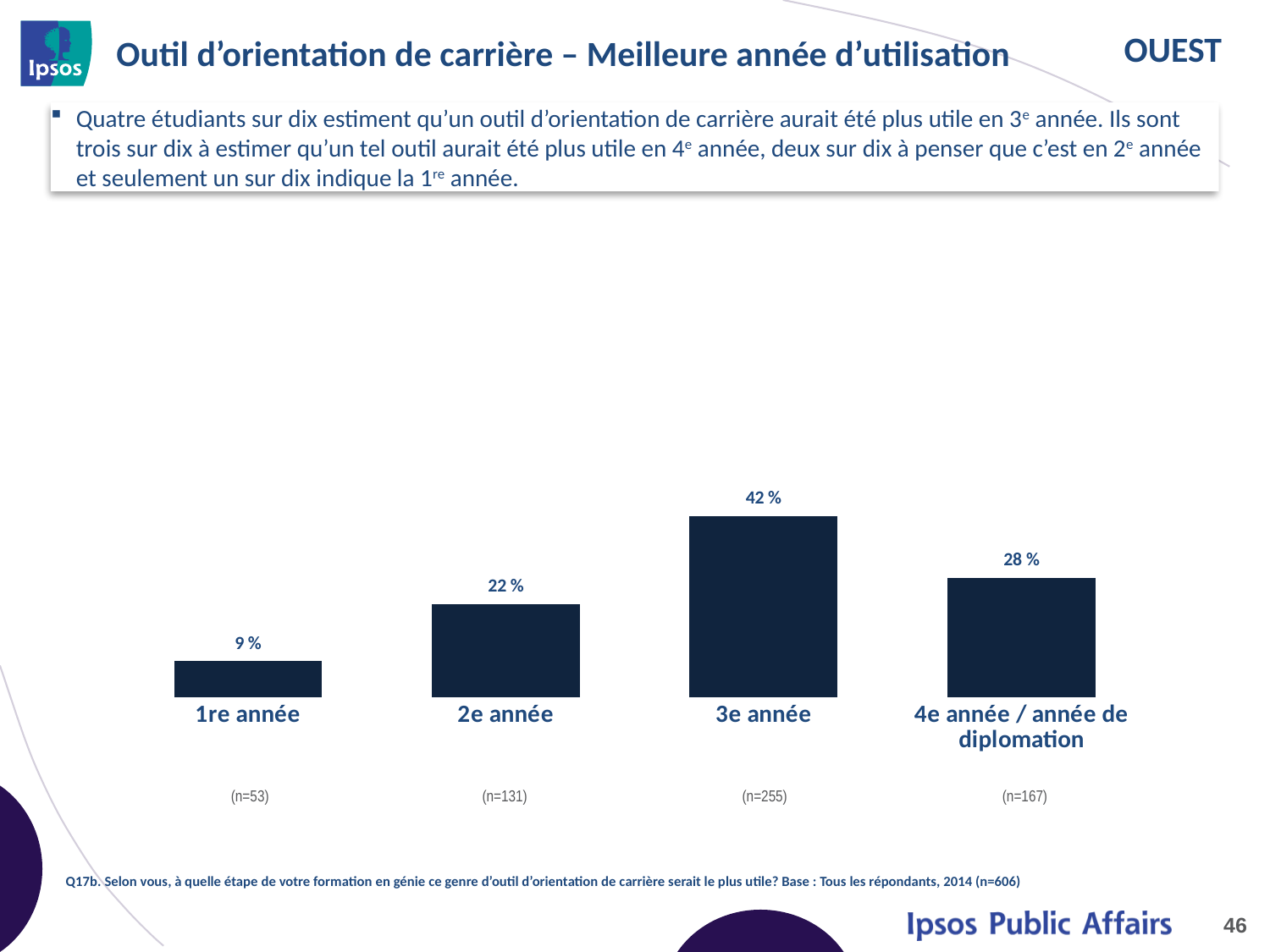
What is the value for 4e année / année de diplomation? 28 % What is the value for 1re année? 9 % What is the difference between the values for 3e année and 4e année / année de diplomation? 14 % Which category has the lowest value? 1re année What kind of chart is shown on the slide? Bar chart What is the value for 2e année? 22 % What is the sample size (n) shown under the 3e année bar? (n=255) What is the difference between the values for 2e année and 1re année? 13 % Which category has the highest value? 3e année How many categories are shown in the chart? 4 What is the value for 3e année? 42 % Which is larger, the value for 2e année or the value for 4e année / année de diplomation? 4e année / année de diplomation